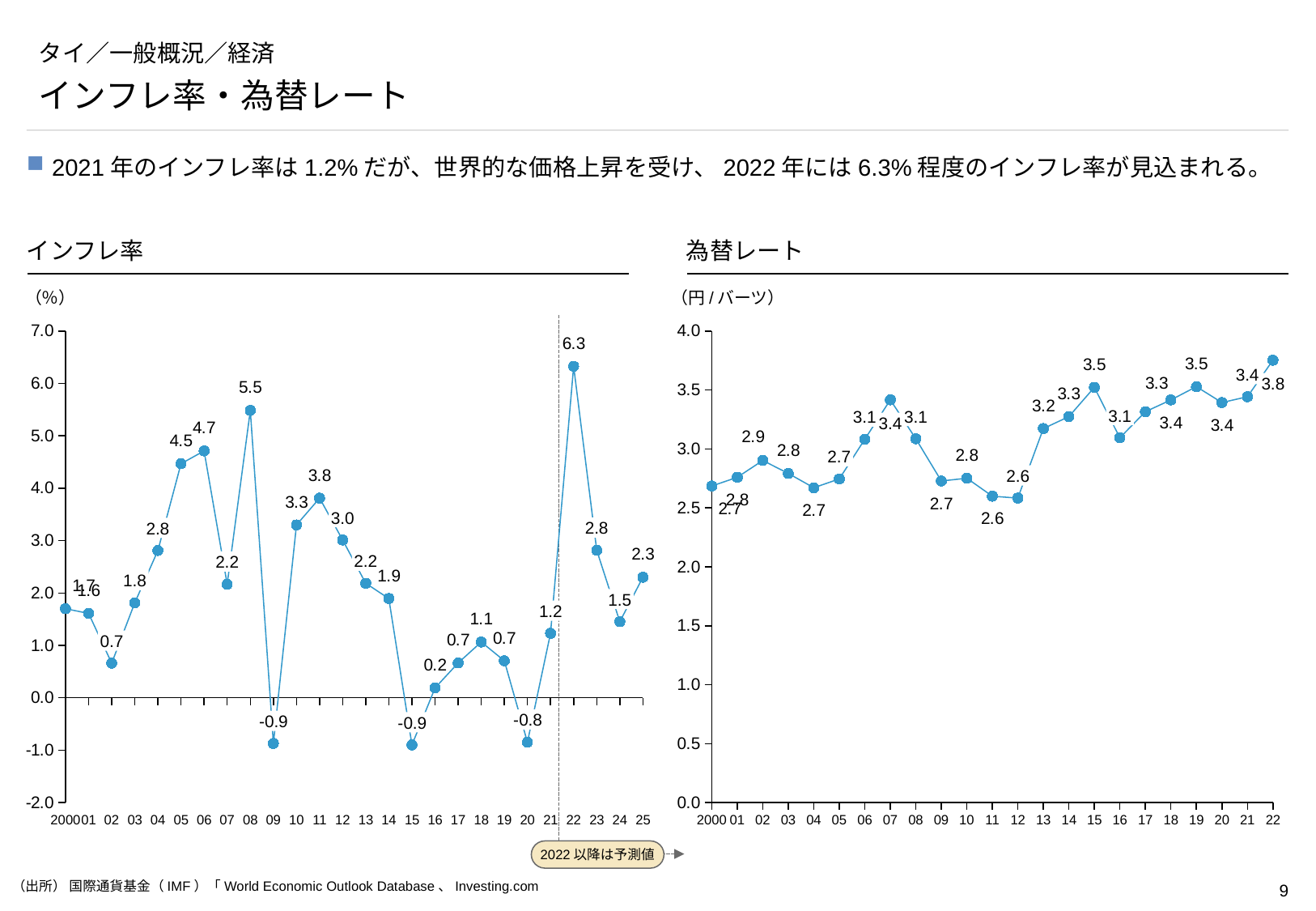
How many data points are plotted on the 為替レート chart? 23 On the 為替レート chart, what is the value for 2011? 2.6 On the 為替レート chart, which year has the highest value? 2022 On the 為替レート chart, what is the difference between the values for 2015 and 2016? 0.4 On the インフレ率 chart, which year has the highest value? 2022 On the インフレ率 chart, what is the value for 2022? 6.3 On the インフレ率 chart, what is the difference between the values for 2022 and 2021? 5.1 On the インフレ率 chart, what is the value for 2008? 5.5 On the インフレ率 chart, which is larger, the value for 2005 or the value for 2006? 2006 On the 為替レート chart, what is the value for 2022? 3.8 On the インフレ率 chart, what is the value for 2020? -0.8 What kind of chart is the インフレ率 chart? Line chart